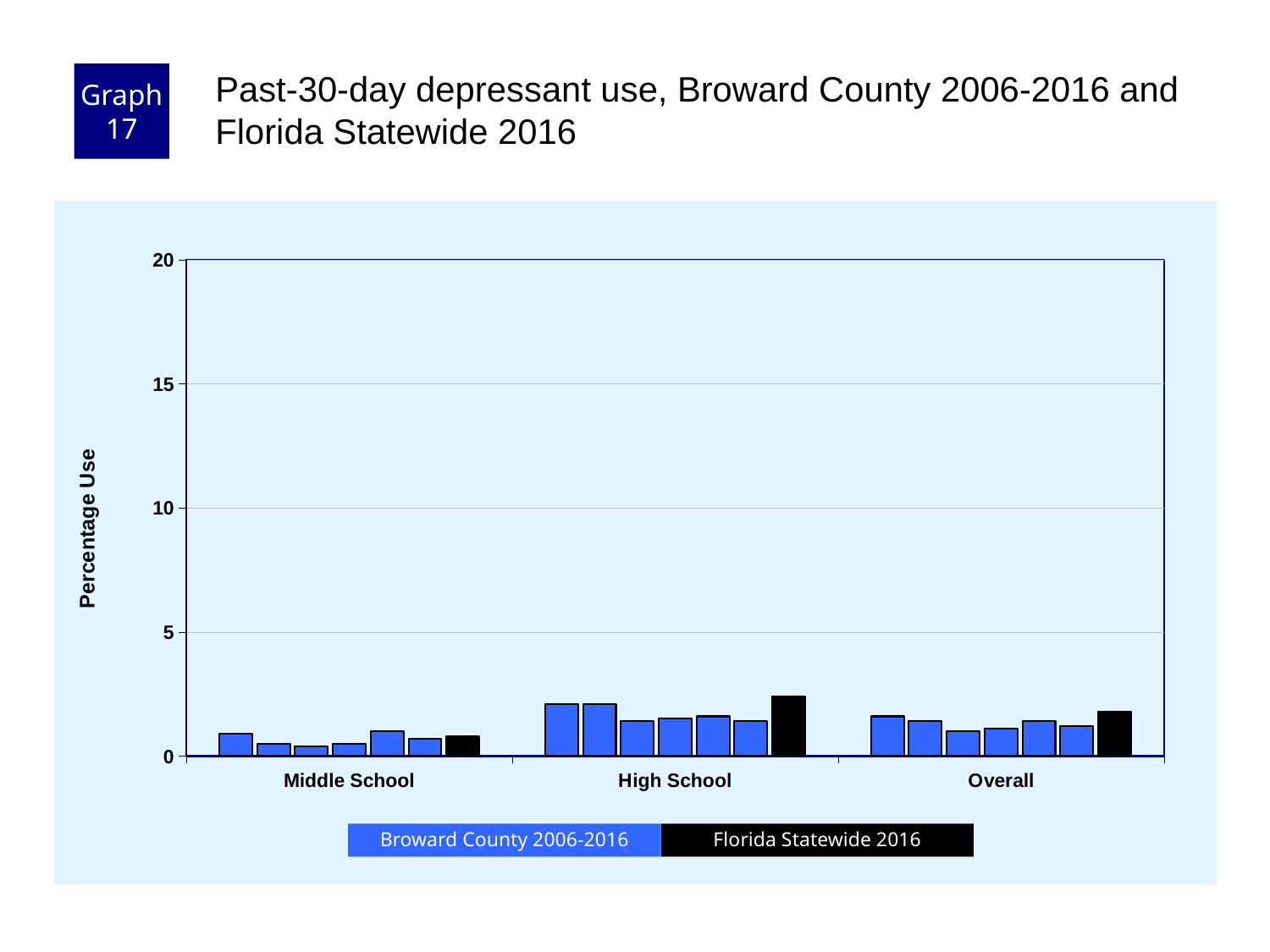
Is the Florida Statewide 2016 value for High School greater or less than 5? less Which is larger, the Florida Statewide 2016 value for High School or for Middle School? High School How many categories are shown on the x axis of the chart? 3 Is the Florida Statewide 2016 value for Overall greater or less than 10? less What kind of chart is shown on the slide? bar chart Which is larger, the Florida Statewide 2016 value for Overall or for Middle School? Overall How many series does the chart's legend list? 2 Which category has the highest Florida Statewide 2016 value? High School Is the Florida Statewide 2016 value for Middle School greater or less than 5? less Which category has the lowest Florida Statewide 2016 value? Middle School Which colour represents Florida Statewide 2016 in the chart's legend? black What is the label on the y axis of the chart? Percentage Use